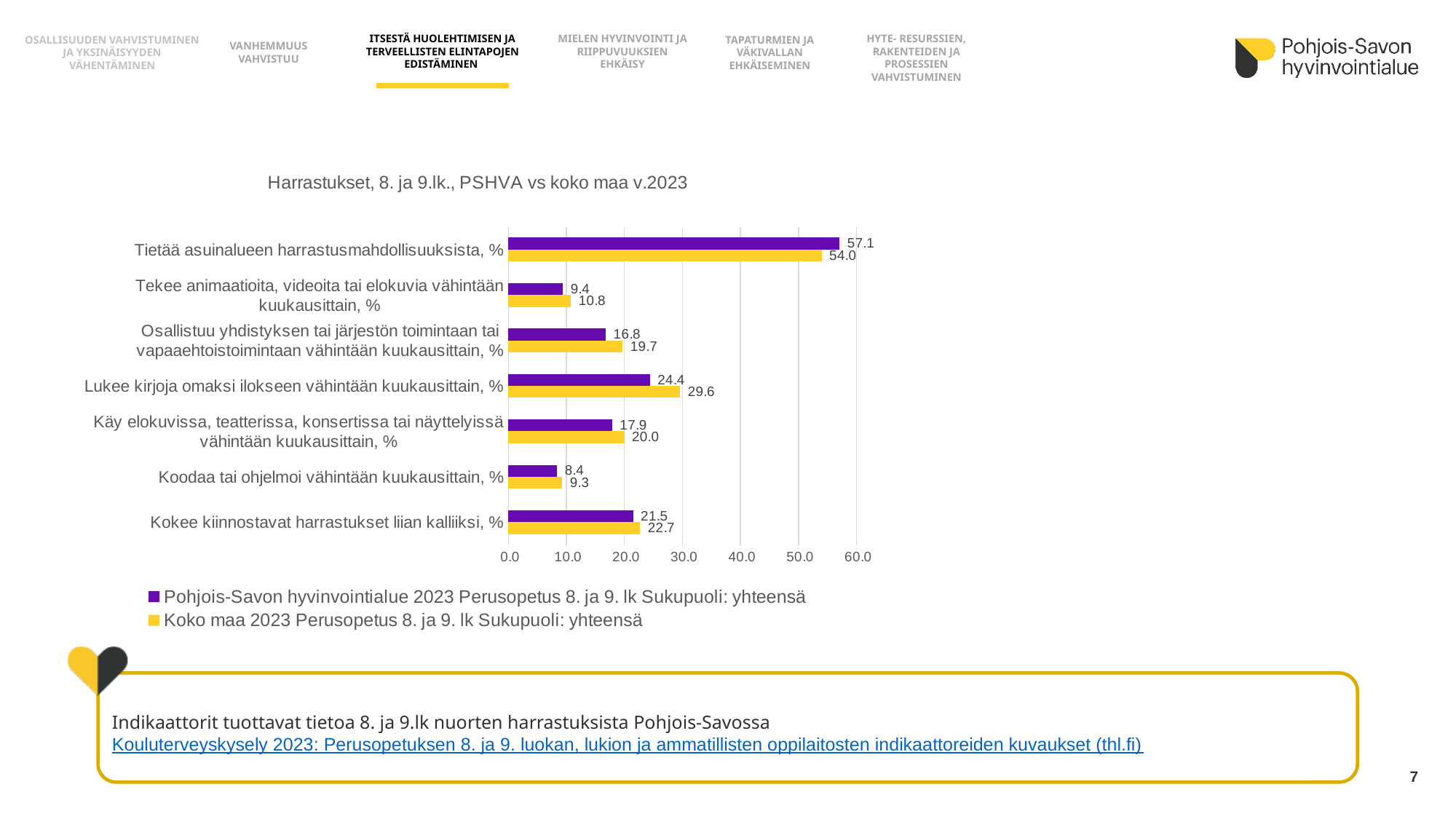
Is the Koko maa value for 'Kokee kiinnostavat harrastukset liian kalliiksi, %' greater or less than 20.0? greater What is the title of the chart? Harrastukset, 8. ja 9.lk., PSHVA vs koko maa v.2023 Which category has the lowest value for the Pohjois-Savon hyvinvointialue series? Koodaa tai ohjelmoi vähintään kuukausittain, % Which category has the highest value for the Koko maa series? Tietää asuinalueen harrastusmahdollisuuksista, % How many series does the legend list? 2 What is the value for 'Lukee kirjoja omaksi ilokseen vähintään kuukausittain, %' for the Koko maa series? 29.6 How many categories are shown on the chart? 7 What type of chart is shown on the slide? Bar chart What is the value for 'Koodaa tai ohjelmoi vähintään kuukausittain, %' for the Pohjois-Savon hyvinvointialue series? 8.4 For 'Tietää asuinalueen harrastusmahdollisuuksista, %', which series has the larger value: Pohjois-Savon hyvinvointialue or Koko maa? Pohjois-Savon hyvinvointialue What is the difference between the Koko maa and Pohjois-Savon hyvinvointialue values for 'Lukee kirjoja omaksi ilokseen vähintään kuukausittain, %'? 5.2 What is the value for 'Tietää asuinalueen harrastusmahdollisuuksista, %' for the Pohjois-Savon hyvinvointialue series? 57.1